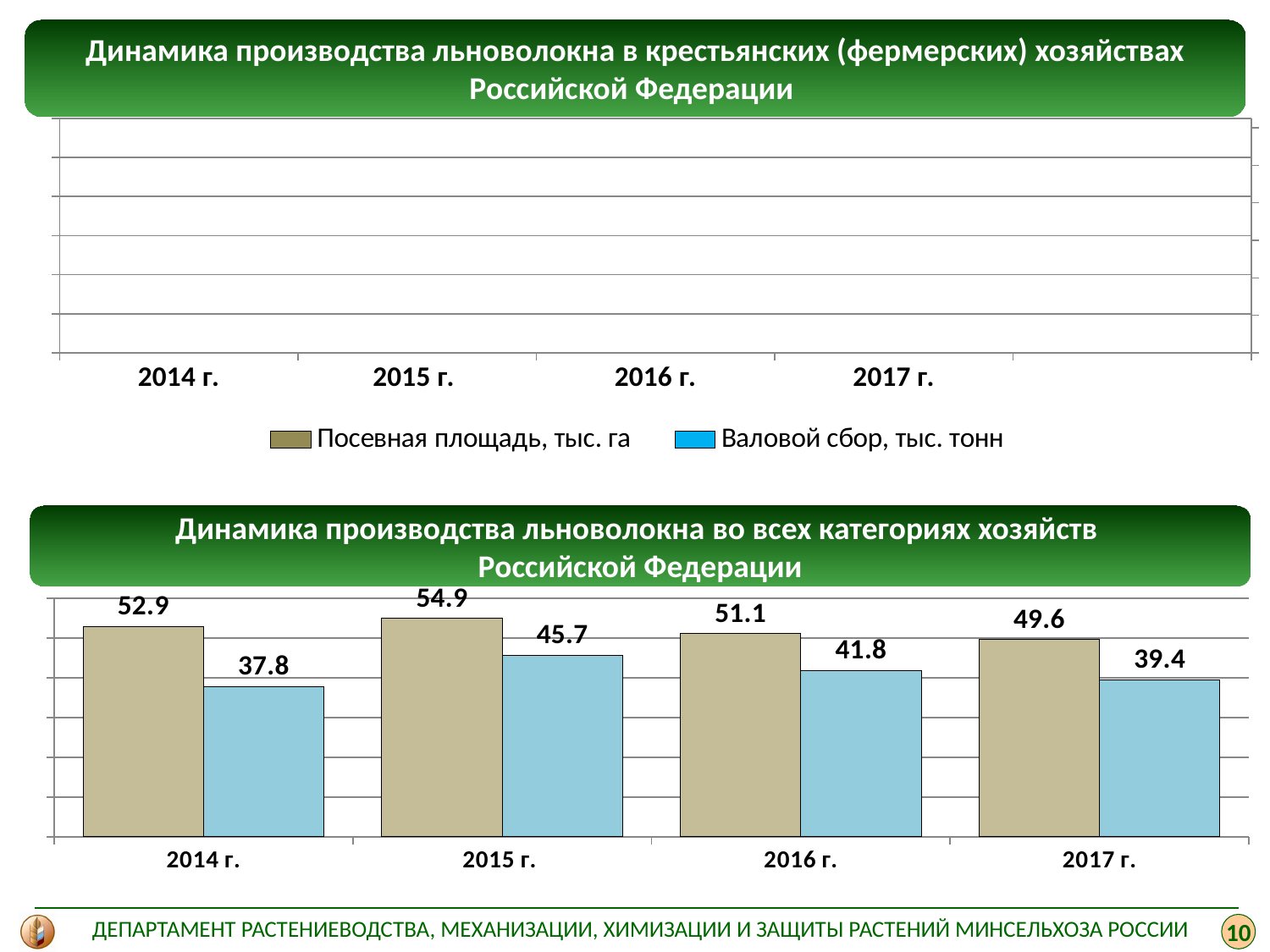
In the bottom chart, do the tan bars (Посевная площадь) rise or fall from 2015 г. to 2017 г.? Fall How many years (categories) are shown on the x axis of the bottom chart? 4 What kind of chart is the bottom chart? Bar chart How many series does the legend of the top chart list? 2 In the bottom chart, what is the value of the blue bar (Валовой сбор) for 2016 г.? 41.8 In the bottom chart, what is the difference between the tan bar and the blue bar for 2017 г.? 10.2 What are the two legend entries shown under the top chart? Посевная площадь, тыс. га; Валовой сбор, тыс. тонн In the bottom chart, what is the difference between the tan bar and the blue bar for 2014 г.? 15.1 In the bottom chart, which year has the lowest blue bar (Валовой сбор)? 2014 г. In the bottom chart, which year has the highest tan bar (Посевная площадь)? 2015 г. In the bottom chart (Динамика производства льноволокна во всех категориях хозяйств), what is the value of the tan bar (Посевная площадь) for 2015 г.? 54.9 In the bottom chart, which is larger: the blue bar for 2015 г. or the blue bar for 2017 г.? 2015 г.